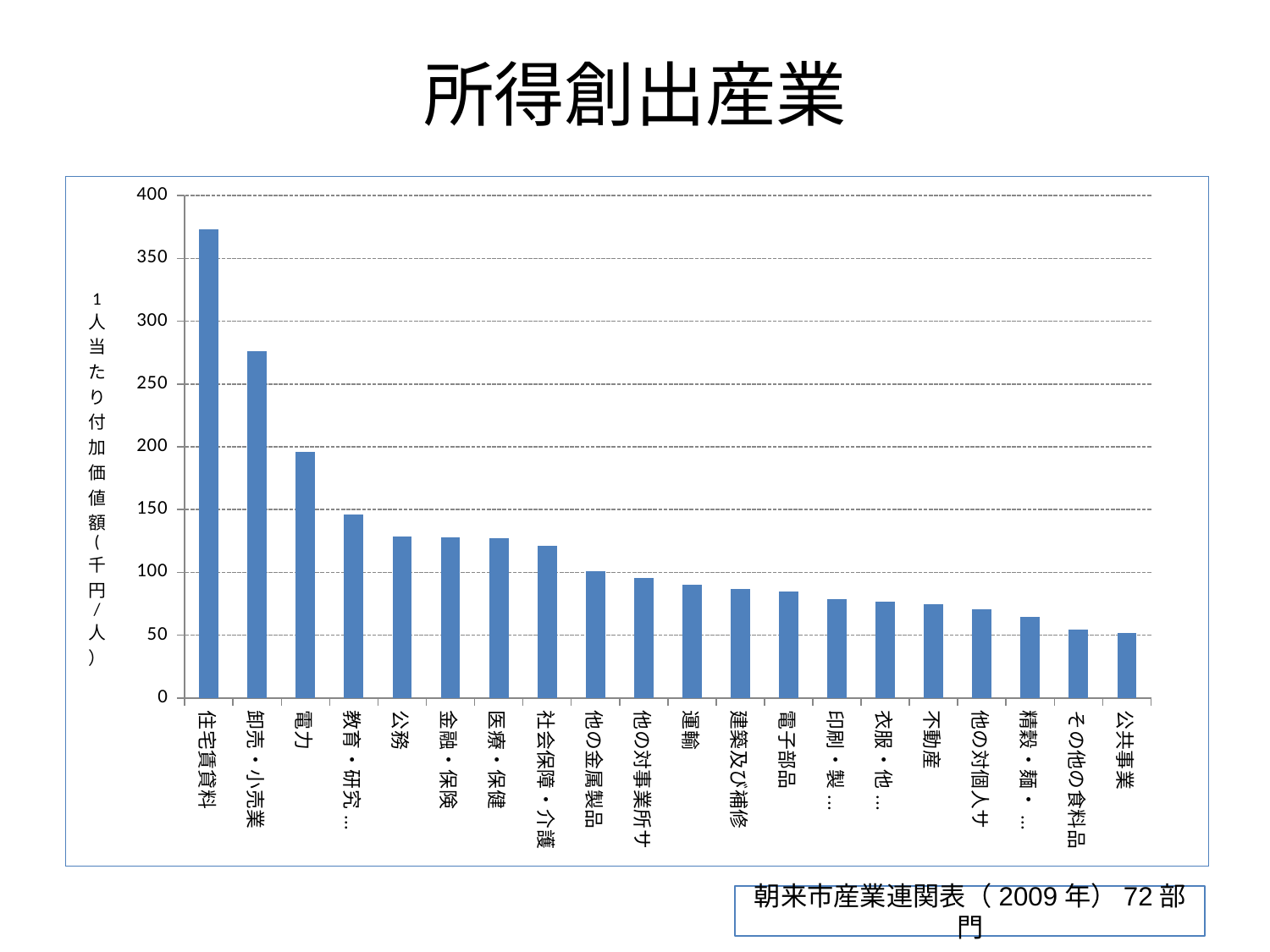
What is the title of the slide? 所得創出産業 What kind of chart is shown on the slide? bar chart What is the label on the vertical axis of the chart? 1人当たり付加価値額（千円/人） Which industry has the highest value in the chart? 住宅賃貸料 Is the value for 卸売・小売業 greater or less than 250? greater Which is larger, the value for 電力 or the value for 公務? 電力 How many categories (industries) are plotted in the chart? 20 Which industry has the lowest value in the chart? 公共事業 Do the values rise or fall moving from left to right along the x axis? fall Is the value for 住宅賃貸料 greater or less than 350? greater Is the value for 運輸 greater or less than 100? less